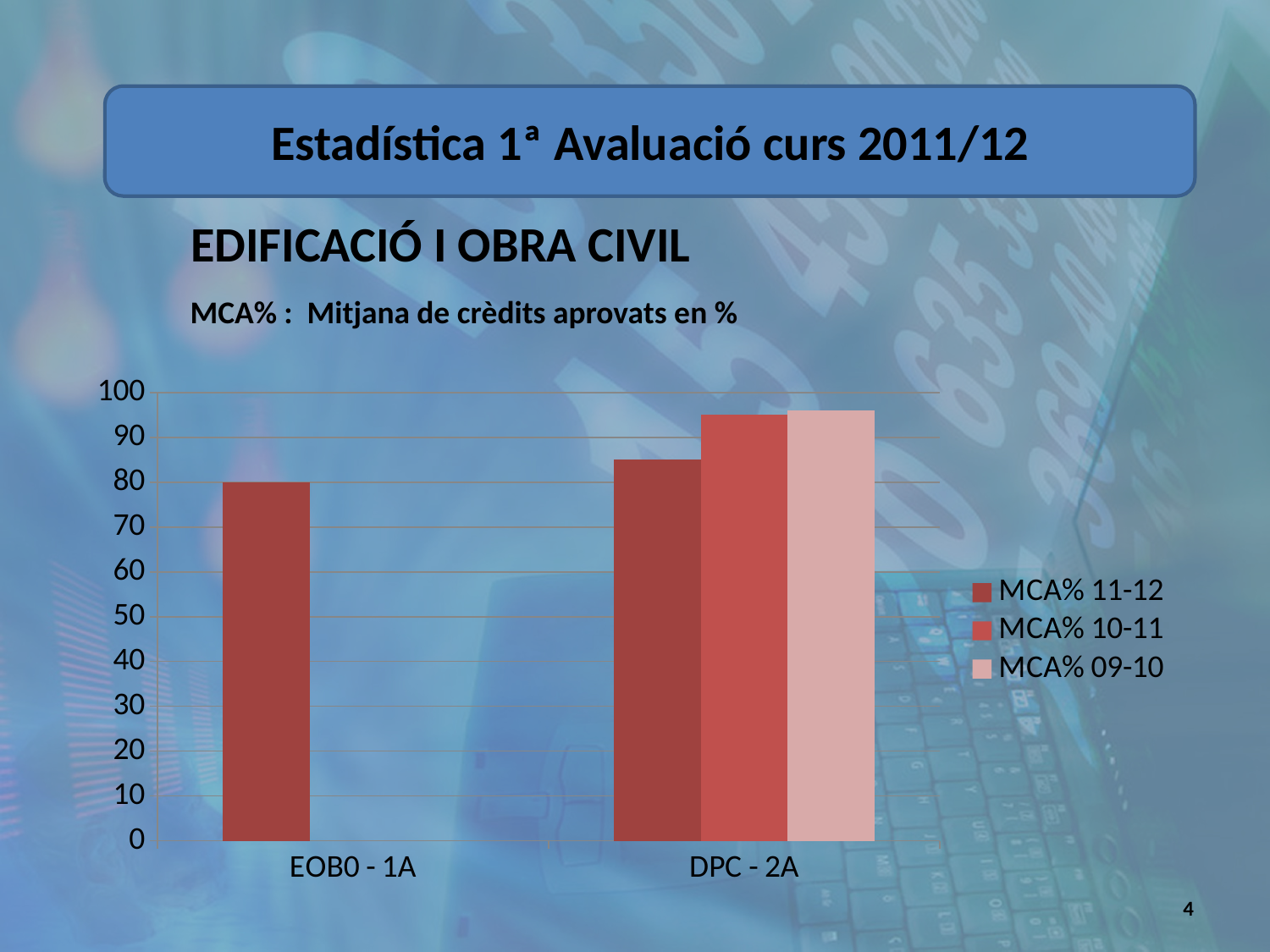
What is the MCA% 11-12 value for EOB0 - 1A? 80 Which category has bars for only one series? EOB0 - 1A What kind of chart is shown on the slide? bar chart Is the MCA% 11-12 value for DPC - 2A greater or less than 90? less How many series does the legend list? 3 Which series is shown in the lightest pink colour in the legend? MCA% 09-10 Is the MCA% 09-10 value for DPC - 2A greater or less than 90? greater Is the MCA% 10-11 value for DPC - 2A greater or less than 90? greater How many categories are shown on the x axis? 2 For DPC - 2A, which is larger, the MCA% 11-12 value or the MCA% 10-11 value? MCA% 10-11 Which category has the higher MCA% 11-12 value, EOB0 - 1A or DPC - 2A? DPC - 2A